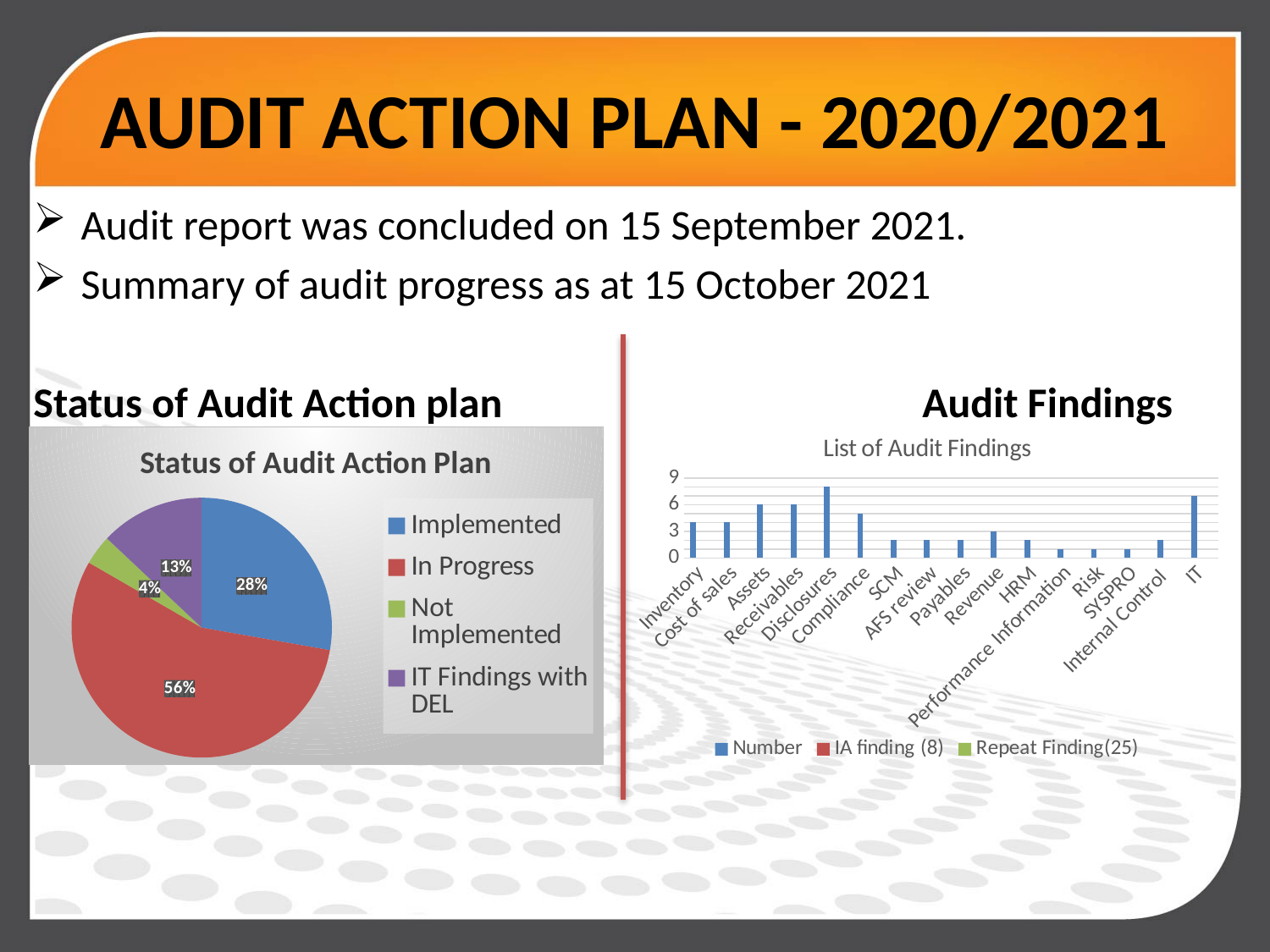
In the Status of Audit Action Plan pie chart, what share is In Progress? 56% In the List of Audit Findings chart, is the value for SCM greater or less than 3? less In the Status of Audit Action Plan pie chart, how many percentage points larger is In Progress than Implemented? 28 In the Status of Audit Action Plan pie chart, which category has the largest share? In Progress How many categories are shown on the x axis of the List of Audit Findings chart? 16 How many series does the legend of the List of Audit Findings chart list? 3 In the Status of Audit Action Plan pie chart, which is larger: Implemented or IT Findings with DEL? Implemented What kind of chart is the List of Audit Findings chart? Bar chart In the Status of Audit Action Plan pie chart, what share is Implemented? 28% In the Status of Audit Action Plan pie chart, what share is IT Findings with DEL? 13% In the List of Audit Findings chart, which category has the highest bar? Disclosures In the Status of Audit Action Plan pie chart, which category has the smallest share? Not Implemented